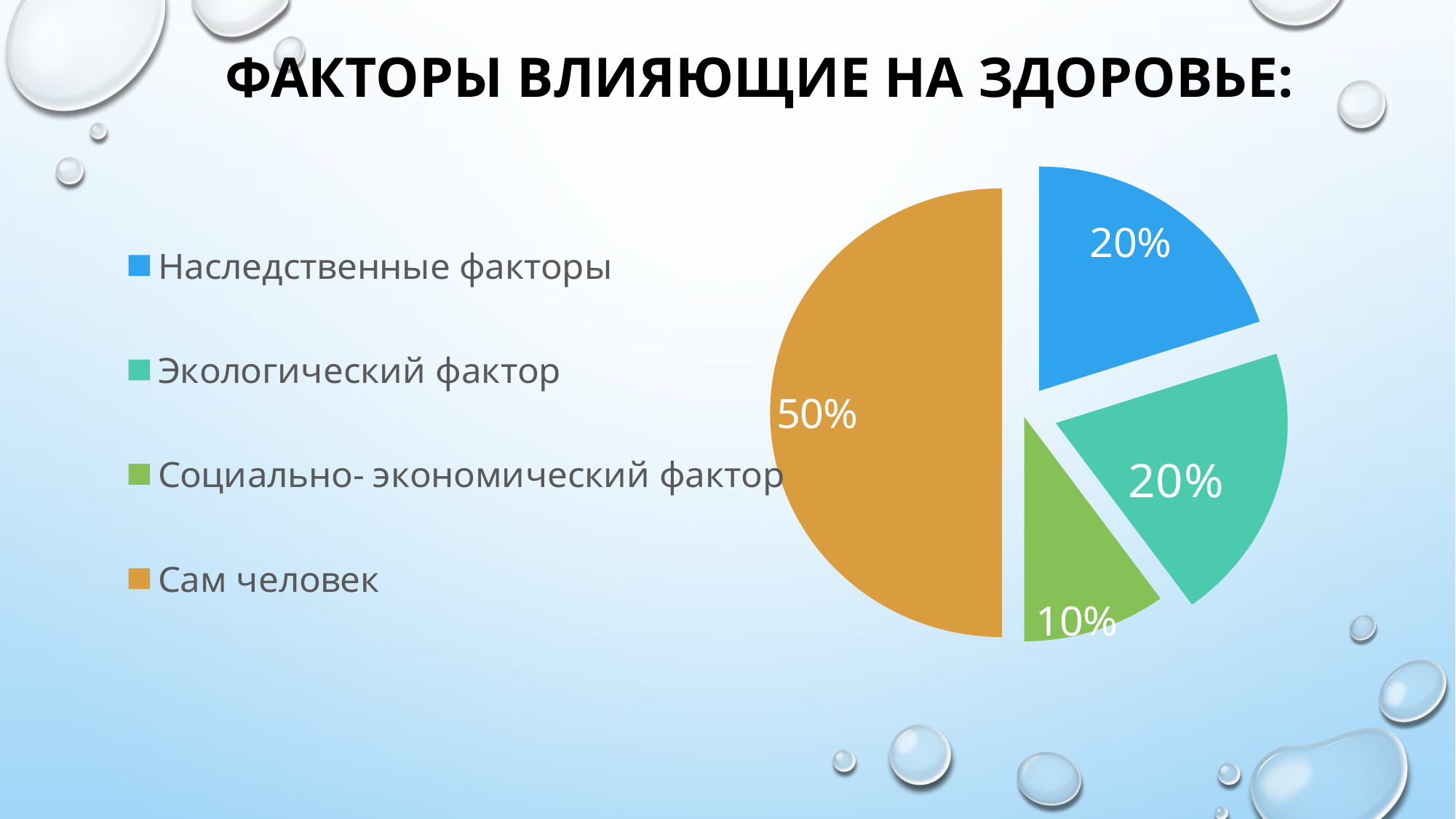
What kind of chart is shown on the slide? Pie chart Which category has the smallest slice of the pie? Социально- экономический фактор Which is larger: the value for "Наследственные факторы" or the value for "Социально- экономический фактор"? Наследственные факторы What share of the pie does "Сам человек" have? 50% How many slices does the pie chart have? 4 What colour is the slice for "Сам человек"? Orange What is the value shown for "Социально- экономический фактор"? 10% What is the value shown for "Экологический фактор"? 20% Which category has the largest slice of the pie? Сам человек What is the value shown for "Наследственные факторы"? 20% What is the title of the slide containing the chart? ФАКТОРЫ ВЛИЯЮЩИЕ НА ЗДОРОВЬЕ: What is the difference between the values for "Сам человек" and "Социально- экономический фактор"? 40%